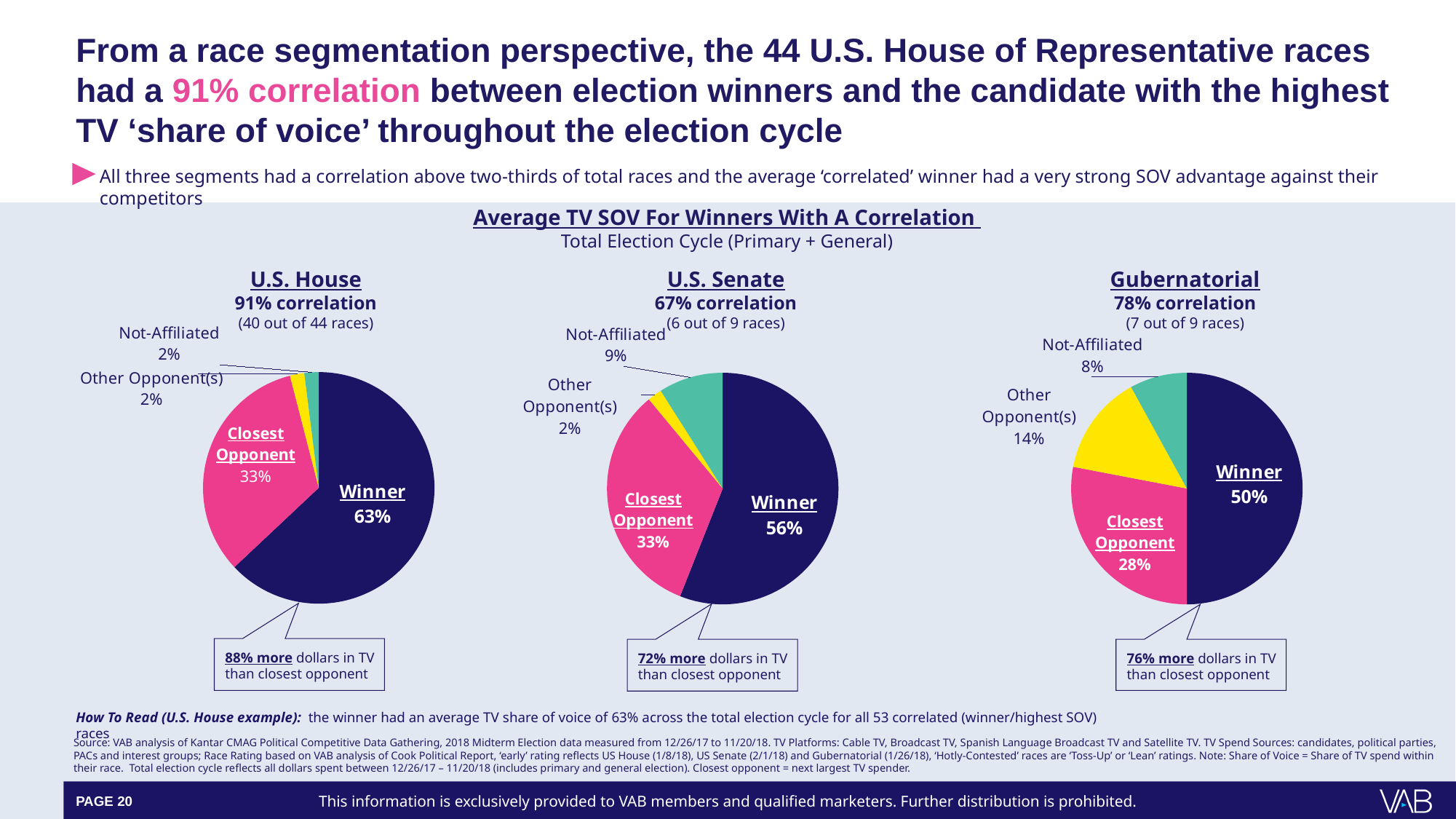
In the Gubernatorial pie chart, what is the difference between the Winner's share and the Closest Opponent's share? 22 percentage points In the U.S. Senate pie chart, which slice is the smallest? Other Opponent(s) In the U.S. House pie chart, what is the difference between the Winner's share and the Closest Opponent's share? 30 percentage points In the U.S. House pie chart, what is the Winner's share? 63% How many slices does the Gubernatorial pie chart have? 4 In the U.S. Senate pie chart, what is the Not-Affiliated share? 9% What correlation percentage is shown above the U.S. Senate pie chart? 67% correlation In the U.S. Senate pie chart, what is the Closest Opponent's share? 33% Which is larger: the Winner's share in the U.S. House pie chart or the Winner's share in the U.S. Senate pie chart? U.S. House In the Gubernatorial pie chart, which slice is the largest? Winner What kind of chart is used for the U.S. House, U.S. Senate and Gubernatorial segments? Pie chart In the Gubernatorial pie chart, what is the share for Other Opponent(s)? 14%